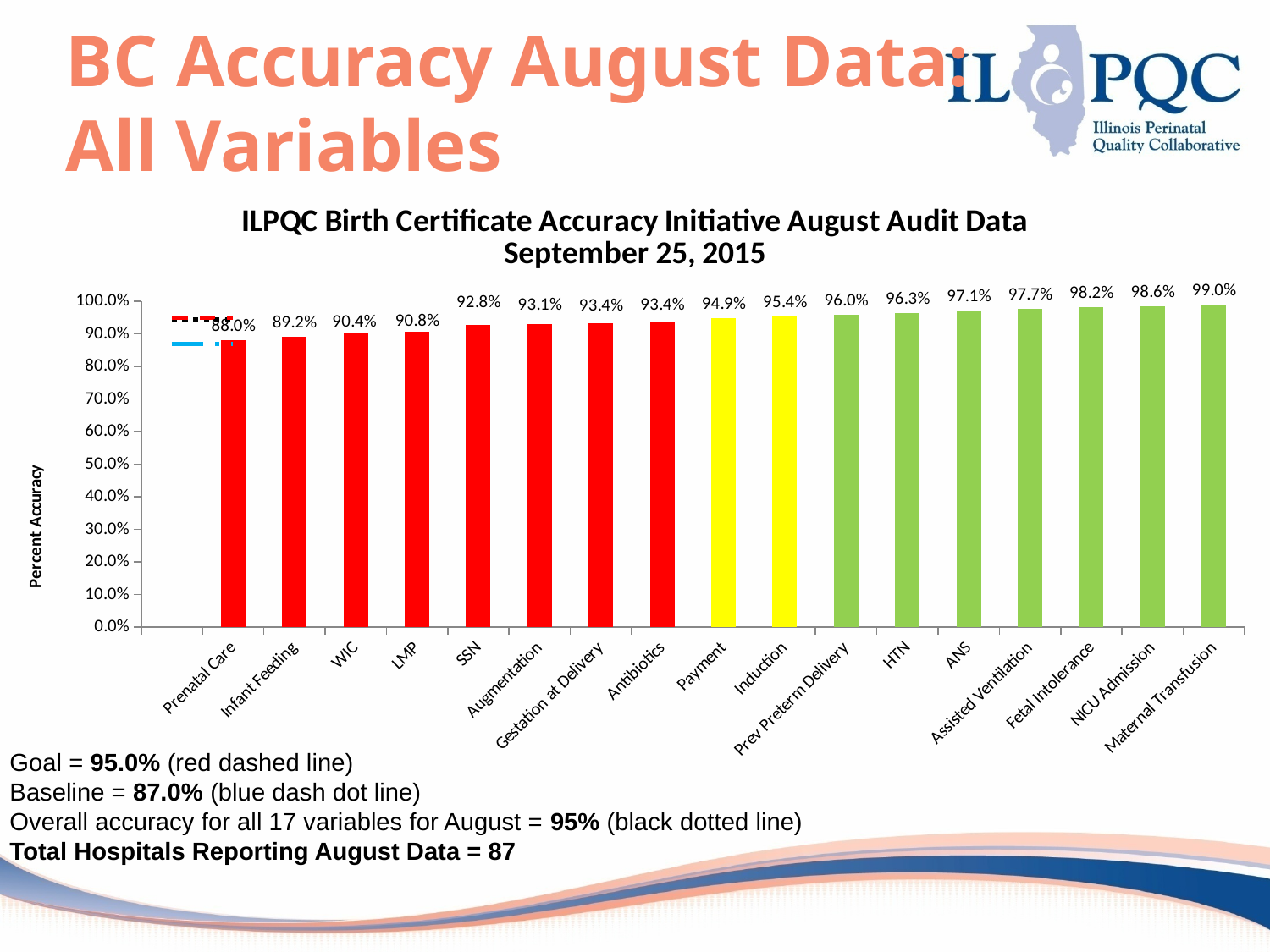
How many variables are shown on the x axis? 17 Which is larger, the value for SSN or the value for Induction? Induction What is the difference between the values for NICU Admission and Infant Feeding? 9.4% What is the label of the y axis? Percent Accuracy What kind of chart is this? Bar chart Which variable has the highest percent accuracy? Maternal Transfusion What is the value for HTN? 96.3% What is the value for Prenatal Care? 88.0% What is the value for Payment? 94.9% Which variable has the lowest percent accuracy? Prenatal Care Do the values rise or fall from left to right along the x axis? Rise What is the value for Maternal Transfusion? 99.0%